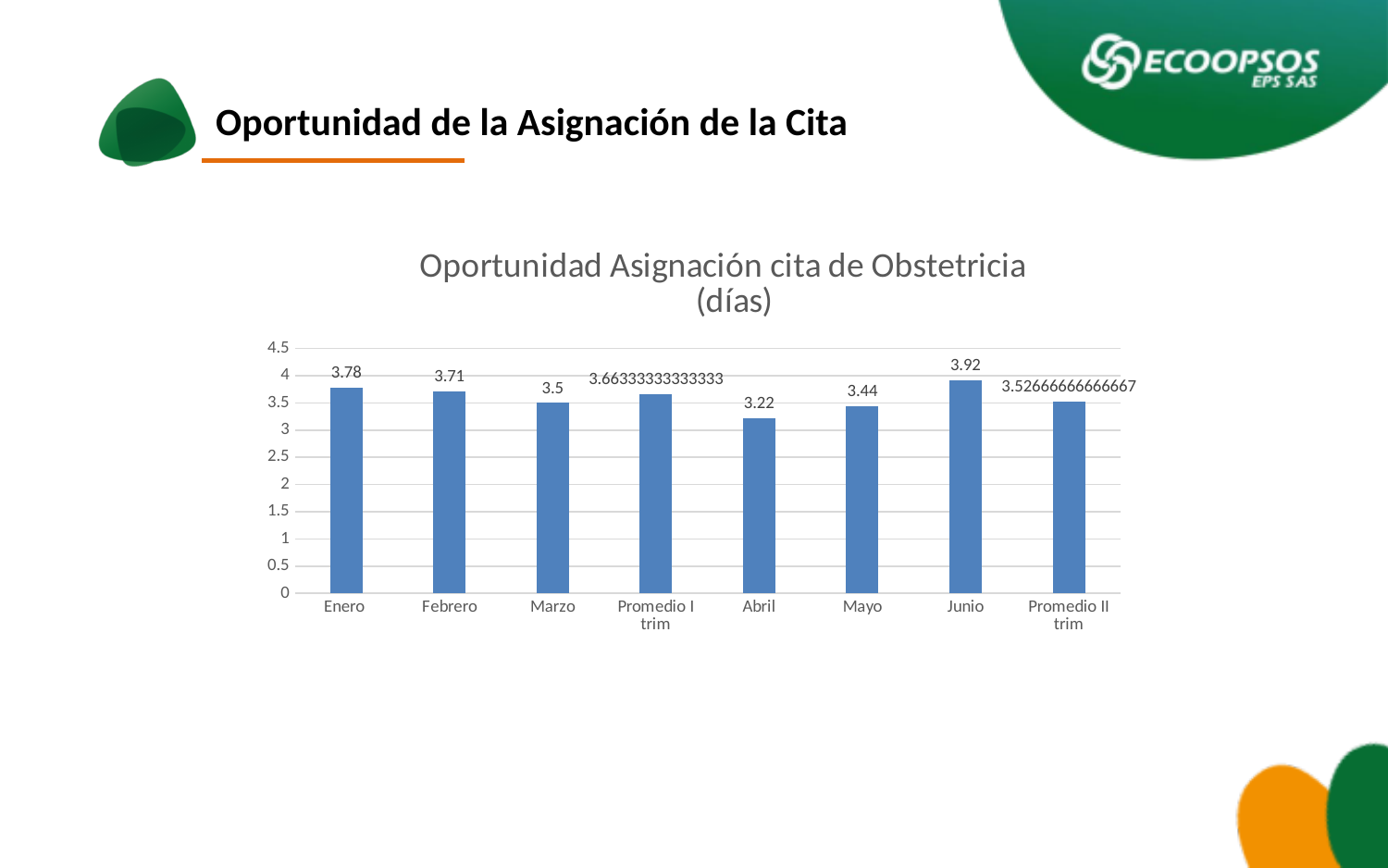
What kind of chart is this? bar chart Is the value for Marzo greater or less than 4? less What is the value for Promedio II trim? 3.52666666666667 How many categories are shown on the x axis? 8 What is the value for Enero? 3.78 What is the title of the chart? Oportunidad Asignación cita de Obstetricia (días) Which category has the highest value? Junio Which category has the lowest value? Abril What is the value for Abril? 3.22 Which is larger, the value for Febrero or the value for Mayo? Febrero What is the value for Promedio I trim? 3.66333333333333 What is the difference between the values for Junio and Abril? 0.7